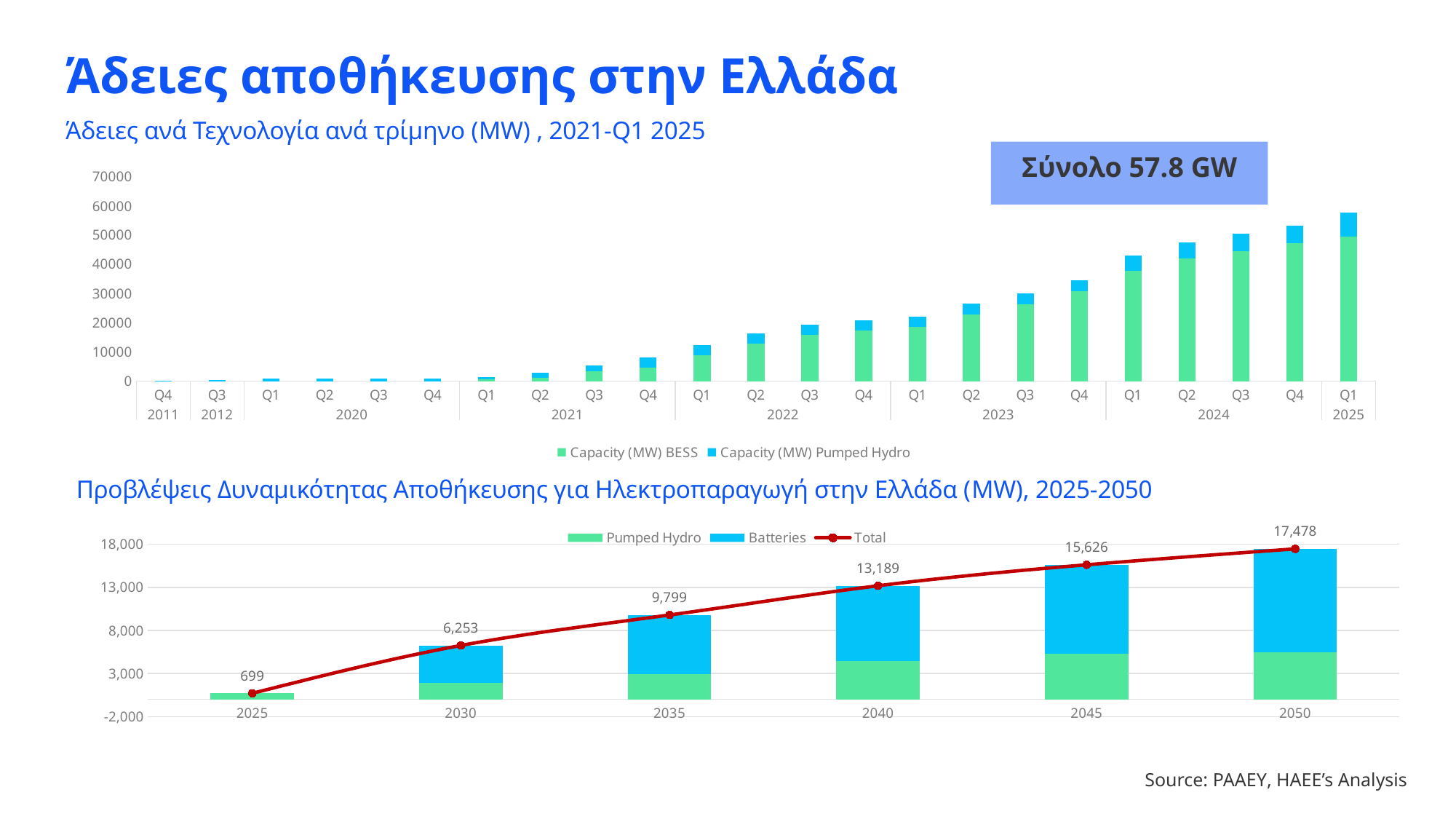
In the bottom chart, which is larger: the Total for 2035 or the Total for 2030? 2035 In the bottom chart, does the Total rise or fall from 2025 to 2050? rise In the bottom chart, how many series does the legend list? 3 In the top chart (Άδειες ανά Τεχνολογία ανά τρίμηνο), how many series does the legend list? 2 In the bottom chart (Προβλέψεις Δυναμικότητας Αποθήκευσης), what is the Total value for 2040? 13,189 In the bottom chart, what is the Total value for 2025? 699 In the top chart, is the total bar height for Q1 2025 greater or less than 50000? greater In the top chart, what total is shown in the highlighted box? Σύνολο 57.8 GW In the bottom chart, which year has the highest Total? 2050 In the bottom chart, what is the difference between the Total for 2050 and the Total for 2045? 1,852 What kind of chart is the top chart (Άδειες ανά Τεχνολογία ανά τρίμηνο)? stacked bar chart In the bottom chart, how many years are shown on the x axis? 6